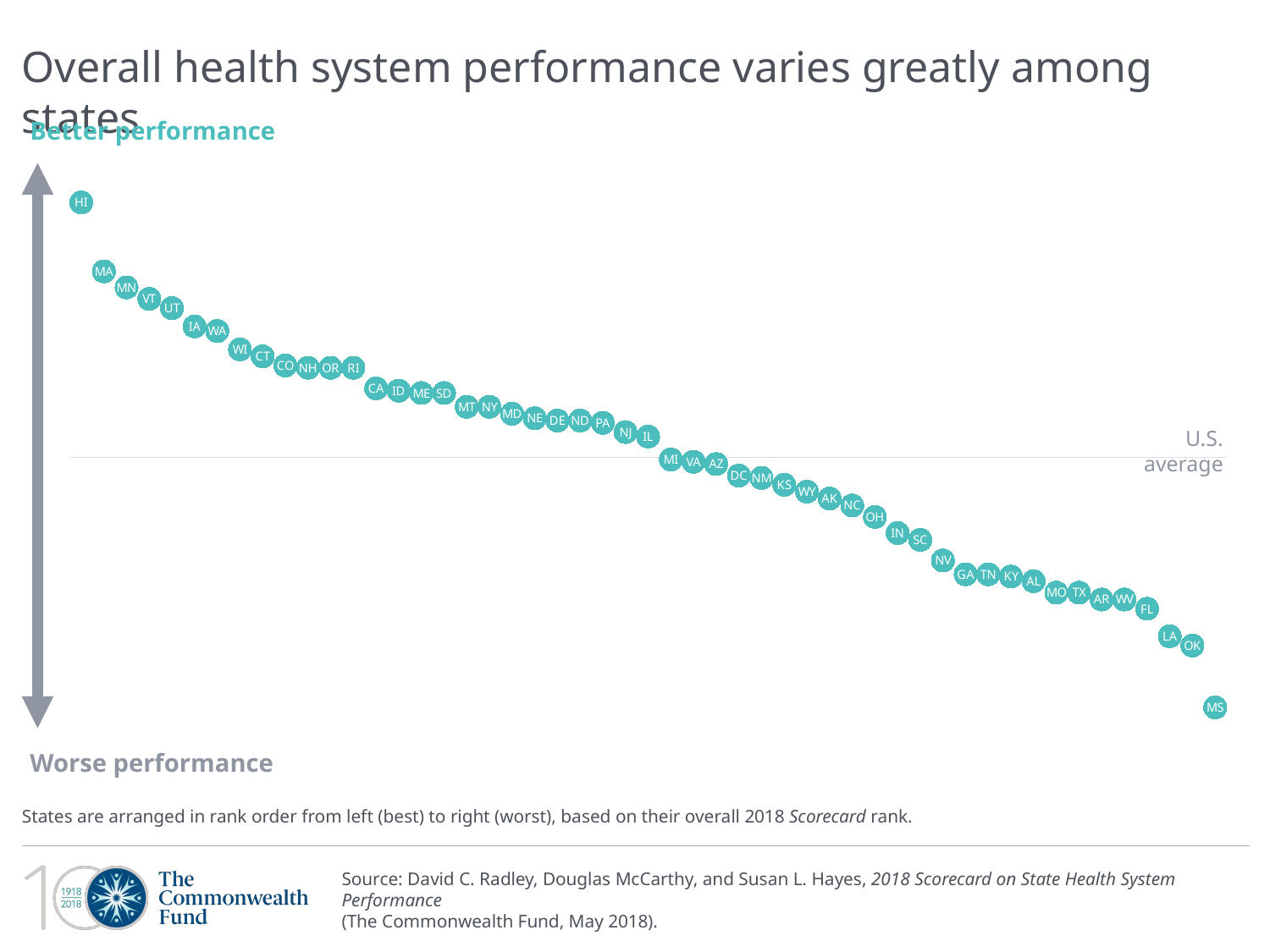
Which state is the first one plotted below the U.S. average line? MI Which state is ranked second, immediately after HI? MA What kind of chart is shown on the slide? Scatter (dot) chart Which performs better on the chart, HI or MS? HI Which state has the best overall health system performance on the chart? HI Which state has the worst overall health system performance on the chart? MS Which performs better on the chart, MA or OK? MA What is the title of the chart on the slide? Overall health system performance varies greatly among states What label appears at the top of the vertical arrow on the chart? Better performance Do the points rise or fall moving from left to right along the chart? Fall Which state is the last one plotted above the U.S. average line? IL How many states (including DC) are plotted on the chart? 51